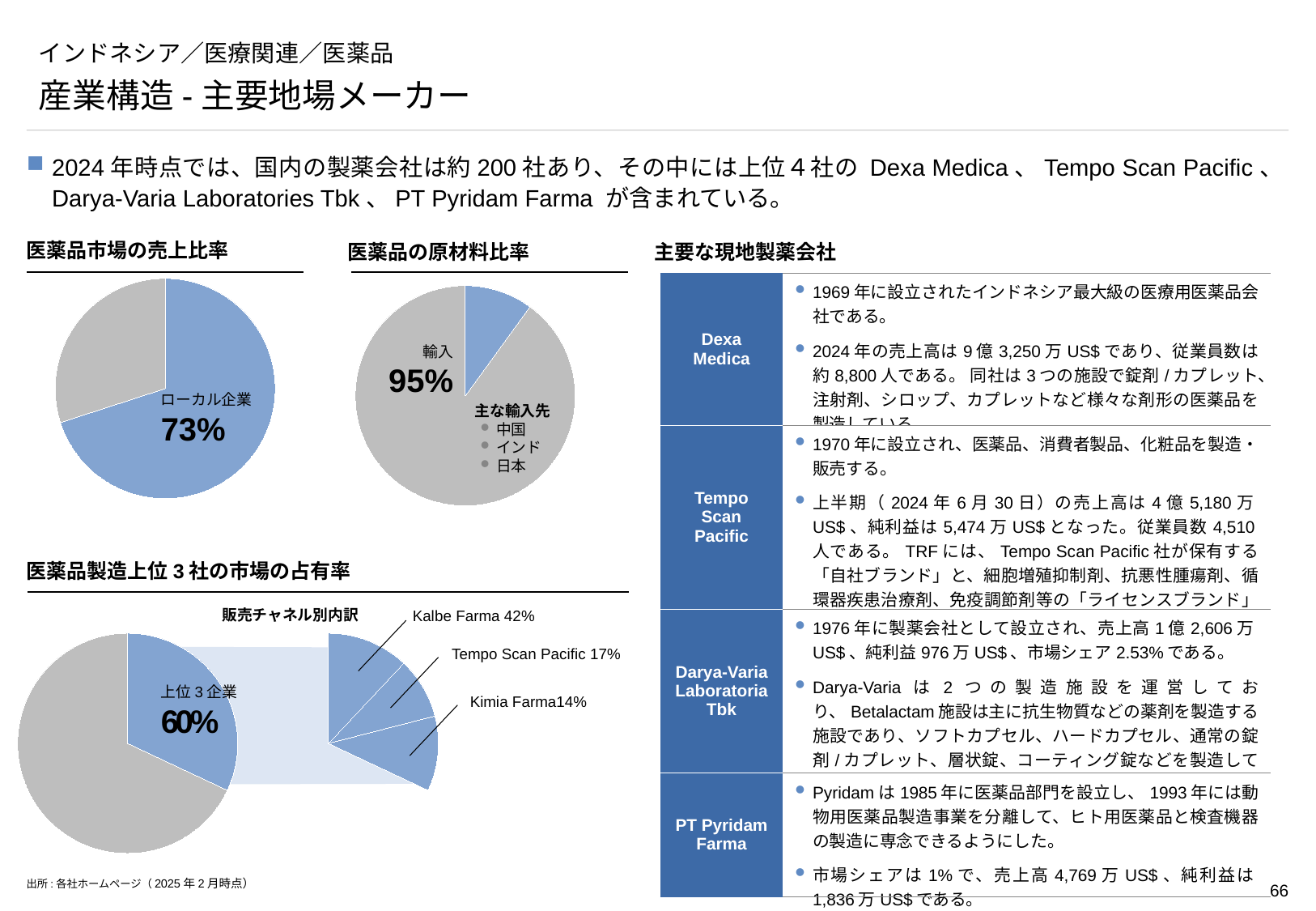
In the 医薬品製造上位3社の市場の占有率 chart, what share is shown for Kimia Farma? 14% In the 医薬品の原材料比率 chart, what share is labelled for 輸入? 95% In the 医薬品の原材料比率 chart, which countries are listed as 主な輸入先? 中国、インド、日本 In the 医薬品製造上位3社の市場の占有率 chart, what share is shown for Kalbe Farma? 42% In the 医薬品市場の売上比率 chart, what share is labelled for ローカル企業? 73% In the 医薬品製造上位3社の市場の占有率 chart, how many percentage points larger is Kalbe Farma's share than Tempo Scan Pacific's? 25 percentage points In the 医薬品製造上位3社の市場の占有率 chart, what share is labelled for 上位3企業? 60% In the 医薬品製造上位3社の市場の占有率 chart, what share is shown for Tempo Scan Pacific? 17% What kind of chart is the 医薬品市場の売上比率 chart? Pie chart In the 医薬品製造上位3社の市場の占有率 chart, which is larger: the share of Tempo Scan Pacific or Kimia Farma? Tempo Scan Pacific In the 医薬品製造上位3社の市場の占有率 chart, which of the three named companies has the smallest share? Kimia Farma In the 医薬品製造上位3社の市場の占有率 chart, which of the three named companies has the largest share? Kalbe Farma